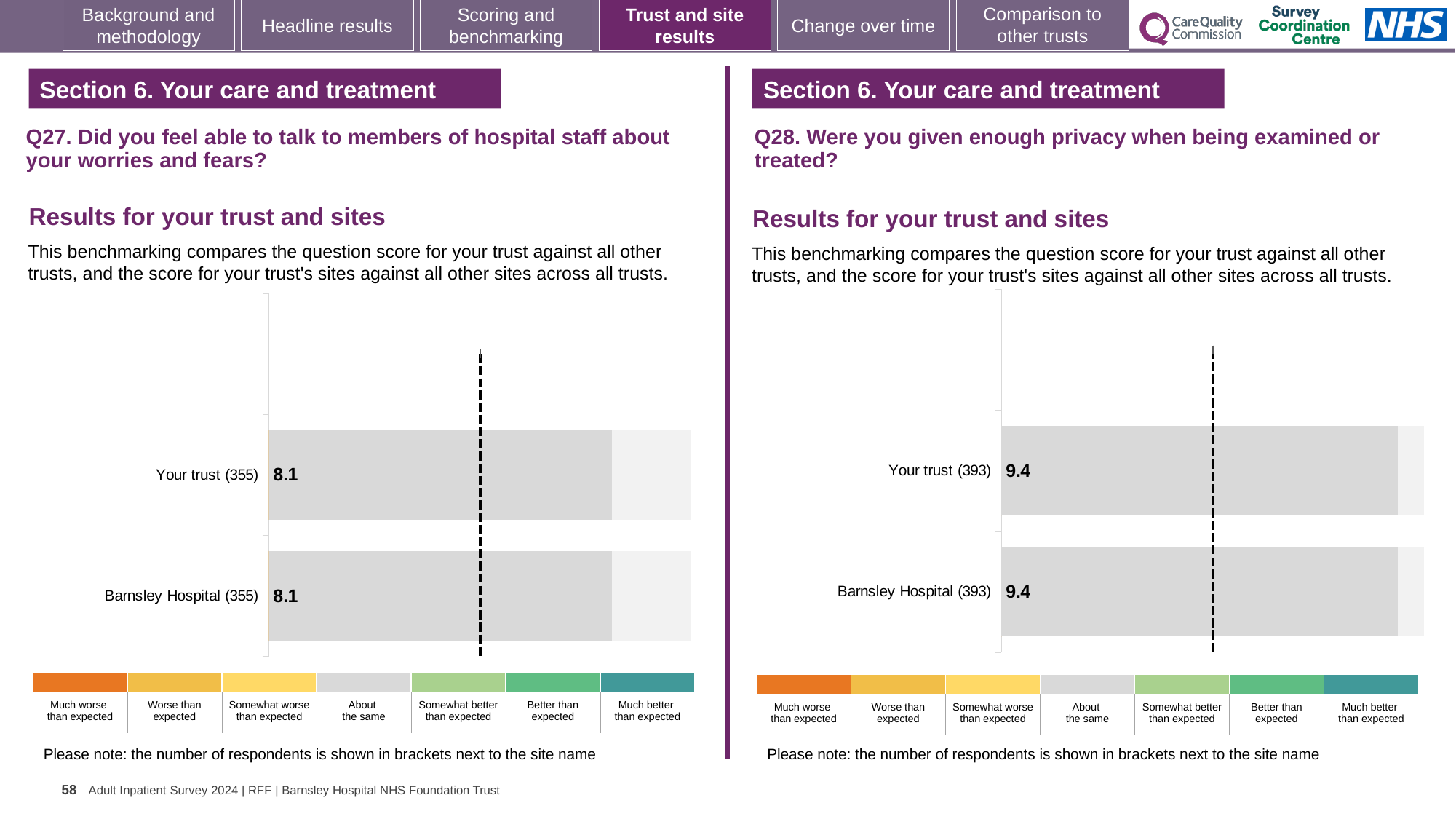
In the Q27 chart on the left, what is the score for Barnsley Hospital? 8.1 In the Q27 chart on the left, how many respondents are shown in brackets next to Your trust? 355 In the Q27 chart on the left, what is the difference between the score for Your trust and the score for Barnsley Hospital? 0 In the Q27 chart on the left, what is the score for Your trust? 8.1 In the Q28 chart on the right, what is the score for Your trust? 9.4 In the Q28 chart on the right, what is the difference between the score for Your trust and the score for Barnsley Hospital? 0 What kind of chart is used for the Q27 results on the left? Bar chart How many bars are plotted in the Q28 chart on the right? 2 How many bars are plotted in the Q27 chart on the left? 2 In the Q28 chart on the right, how many respondents are shown in brackets next to Barnsley Hospital? 393 In the Q28 chart on the right, what is the score for Barnsley Hospital? 9.4